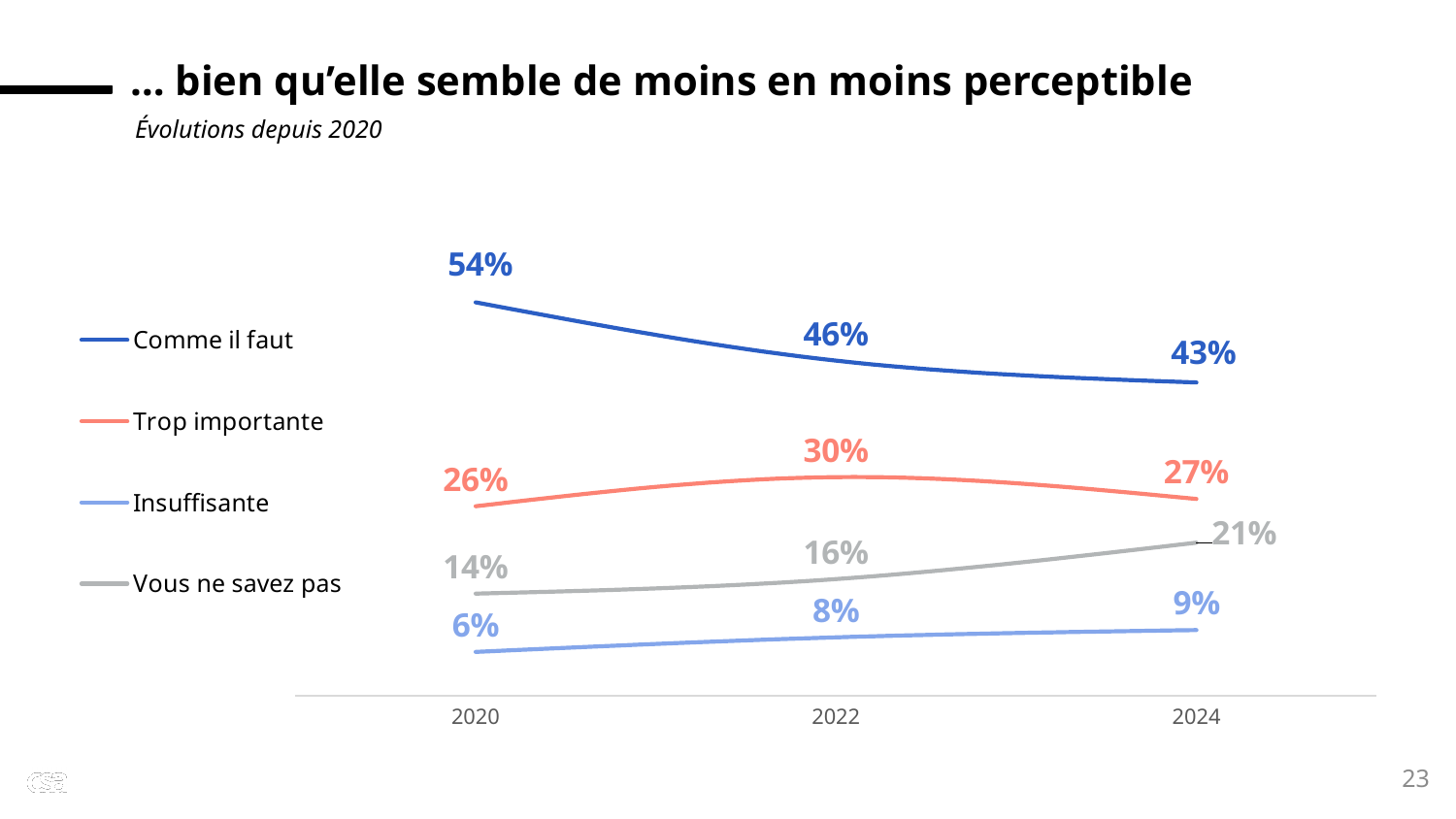
What is the value for "Insuffisante" in 2020? 6% What is the difference between the "Comme il faut" values in 2020 and 2024? 11 percentage points Which series has the highest value in 2024? Comme il faut What kind of chart is shown on the slide? Line chart Which is larger in 2024: "Trop importante" or "Vous ne savez pas"? Trop importante How many years are shown on the x axis? 3 Does the "Comme il faut" series rise or fall from 2020 to 2024? Fall What is the value for "Vous ne savez pas" in 2024? 21% How many series does the legend list? 4 What is the value for "Comme il faut" in 2020? 54% What is the value for "Trop importante" in 2022? 30% Which series has the lowest value in 2022? Insuffisante